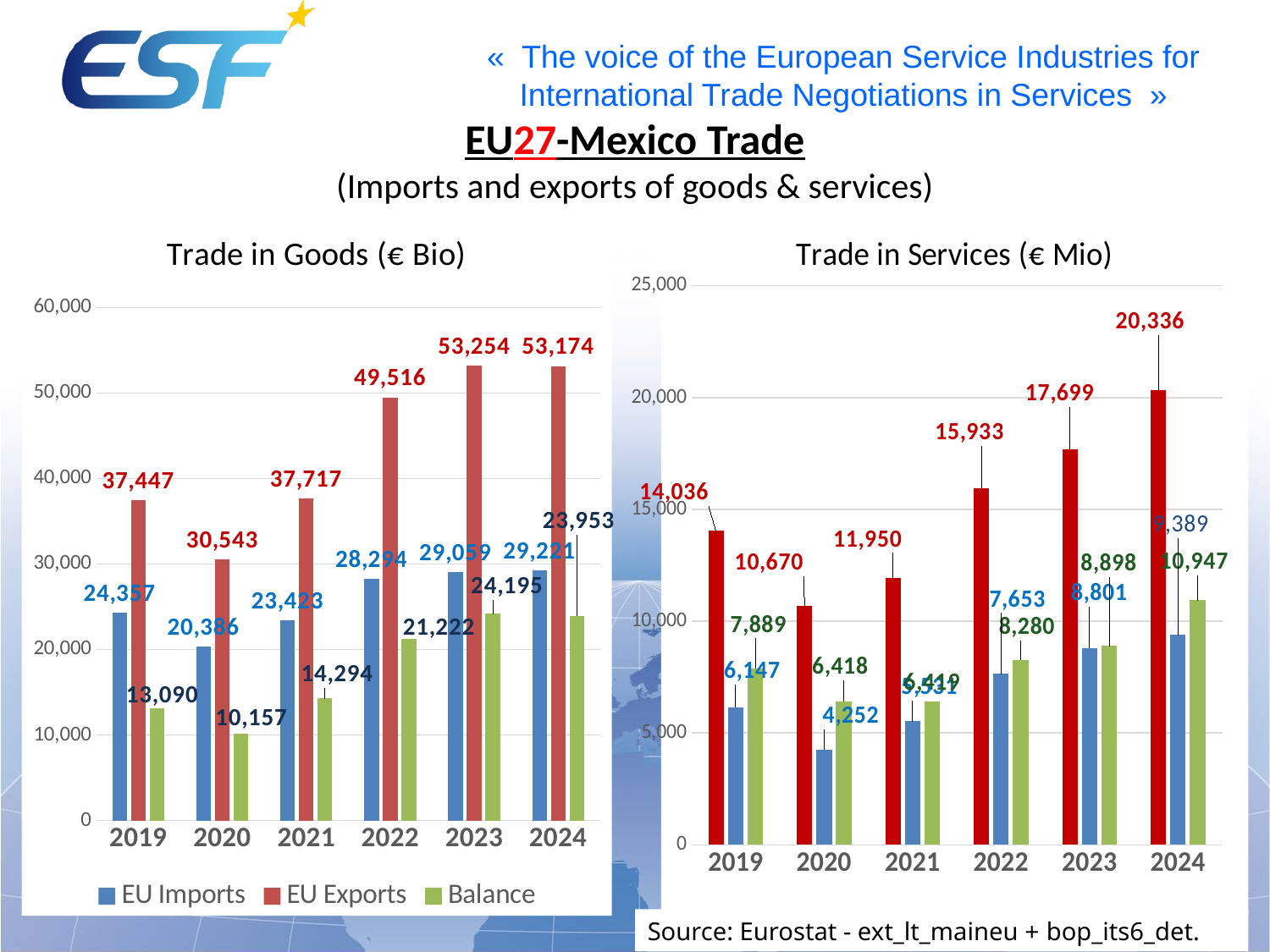
What type of chart is the Trade in Services chart? Bar chart In the Trade in Services chart, what is the value of the red bar for 2024? 20,336 In the Trade in Goods chart, what is the difference between EU Exports and EU Imports in 2024? 23,953 In the Trade in Goods chart, is the EU Exports value for 2022 greater or less than 40,000? greater In the Trade in Goods chart, what is the value of EU Exports for 2023? 53,254 In the Trade in Goods chart, what is the Balance value for 2022? 21,222 In the Trade in Services chart, how many years are shown on the x axis? 6 In the Trade in Goods chart, what is the value of EU Imports for 2020? 20,386 In the Trade in Services chart, which year has the highest red bar? 2024 In the Trade in Goods chart, which year has the lowest EU Imports value? 2020 In the Trade in Goods chart, how many series does the legend list? 3 In the Trade in Services chart, what is the value of the green bar for 2019? 7,889